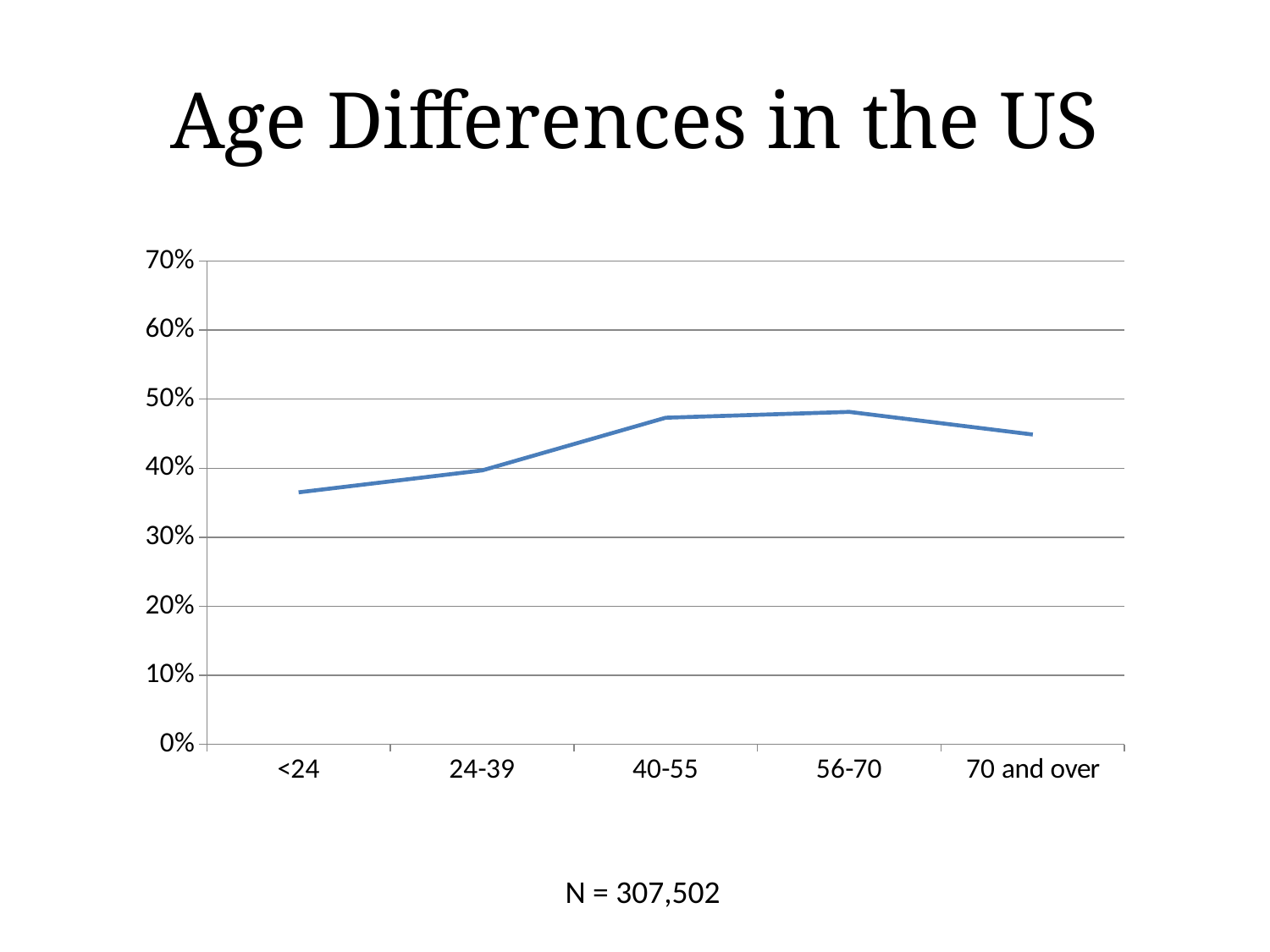
Is the value for 24-39 greater or less than 30%? greater How many age categories are plotted on the x axis? 5 Is the value for 70 and over greater or less than 40%? greater Which has the larger value, 24-39 or 40-55? 40-55 Which has the larger value, <24 or 70 and over? 70 and over Is the value for 40-55 greater or less than 40%? greater Does the line rise or fall between 56-70 and 70 and over? fall What kind of chart is shown on the slide? line chart What is the title of the slide? Age Differences in the US Which age category has the lowest value? <24